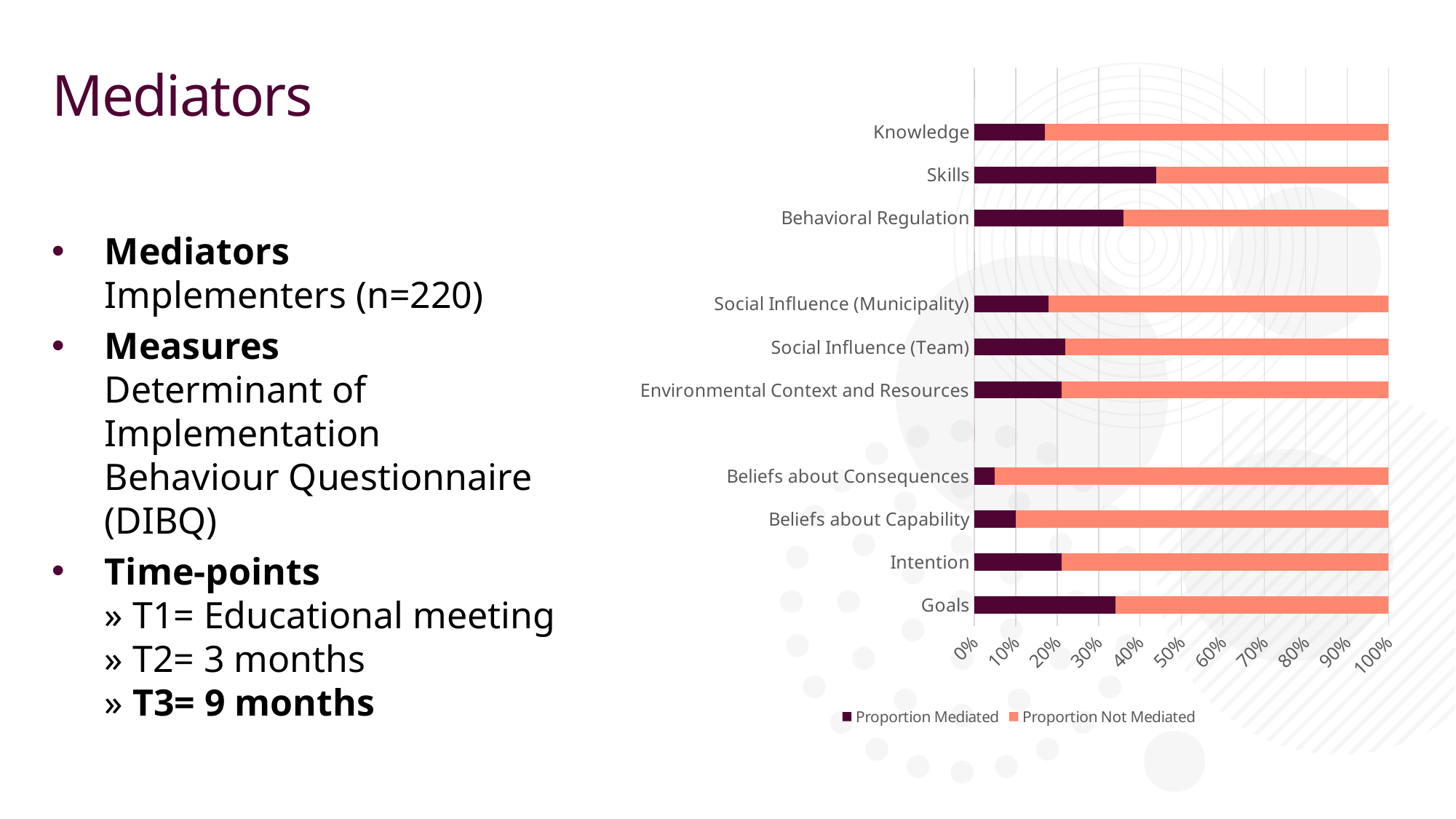
Which category has the lowest Proportion Mediated? Beliefs about Consequences How many series does the chart legend list? 2 Is the Proportion Mediated for Beliefs about Consequences greater or less than 10%? less Is the Proportion Mediated for Skills greater or less than 40%? greater Is the Proportion Mediated for Goals greater or less than 30%? greater What kind of chart is shown on the slide? Stacked bar chart Which category has the highest Proportion Mediated? Skills What is the total of the stacked bar for Knowledge? 100% How many categories are plotted on the chart? 10 What are the two series named in the legend? Proportion Mediated and Proportion Not Mediated Which has a larger Proportion Mediated, Skills or Goals? Skills